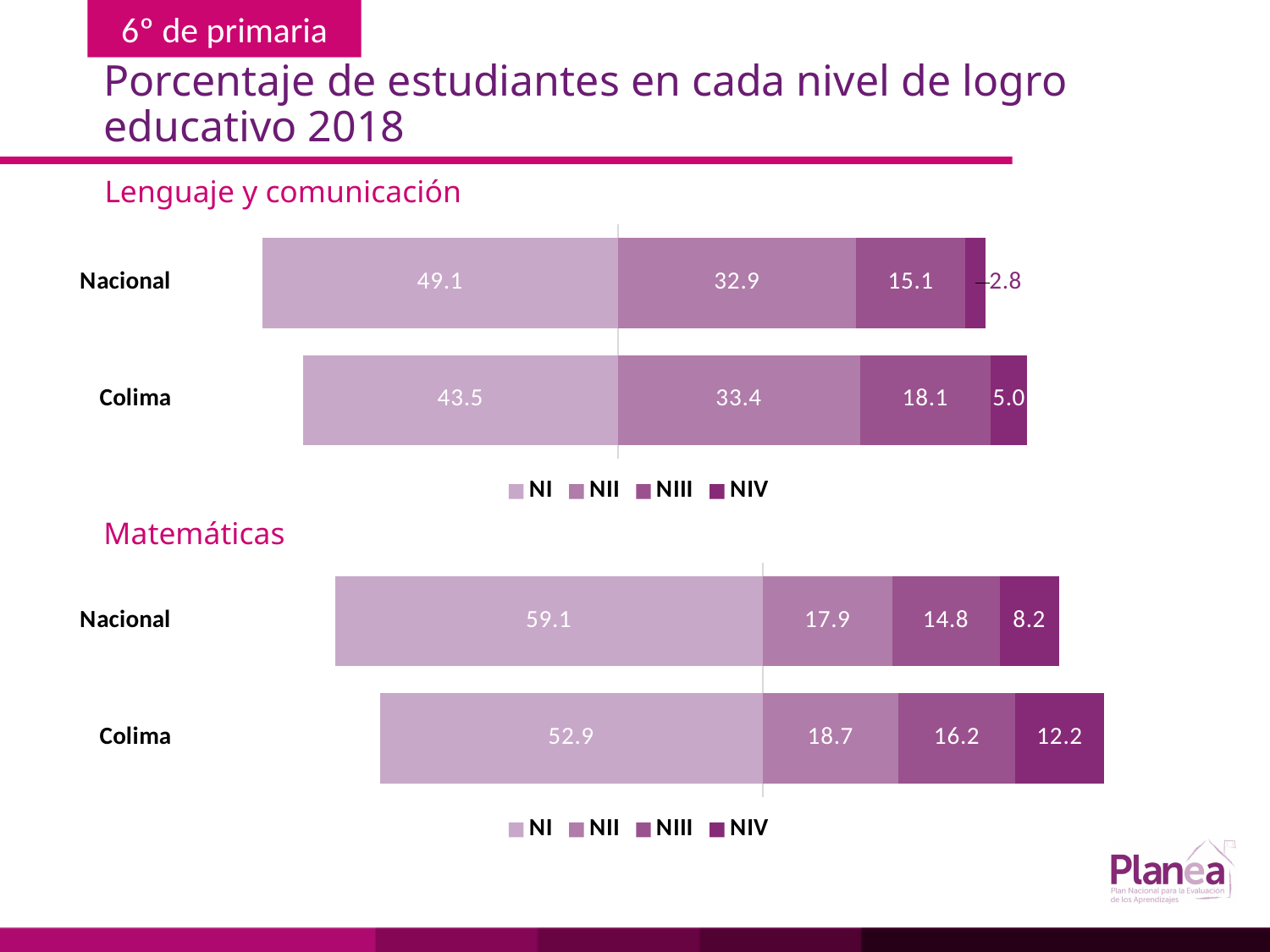
In the Matemáticas chart, what is the NII value for Colima? 18.7 In the Matemáticas chart, what is the difference between the NI values for Nacional and Colima? 6.2 In the Lenguaje y comunicación chart, which level has the lowest value for Nacional? NIV In the Lenguaje y comunicación chart, what is the NIV value for Colima? 5.0 In the Lenguaje y comunicación chart, what is the NI value for Nacional? 49.1 How many categories are shown in the Lenguaje y comunicación chart? 2 In the Matemáticas chart, what is the NIII value for Nacional? 14.8 In the Matemáticas chart, what is the total of the stacked bar for Colima? 100.0 How many series does the legend of the Matemáticas chart list? 4 What kind of chart is the Lenguaje y comunicación chart? Stacked bar chart In the Lenguaje y comunicación chart, which is larger: the NIII value for Nacional or for Colima? Colima In the Matemáticas chart, which level has the highest value for Colima? NI